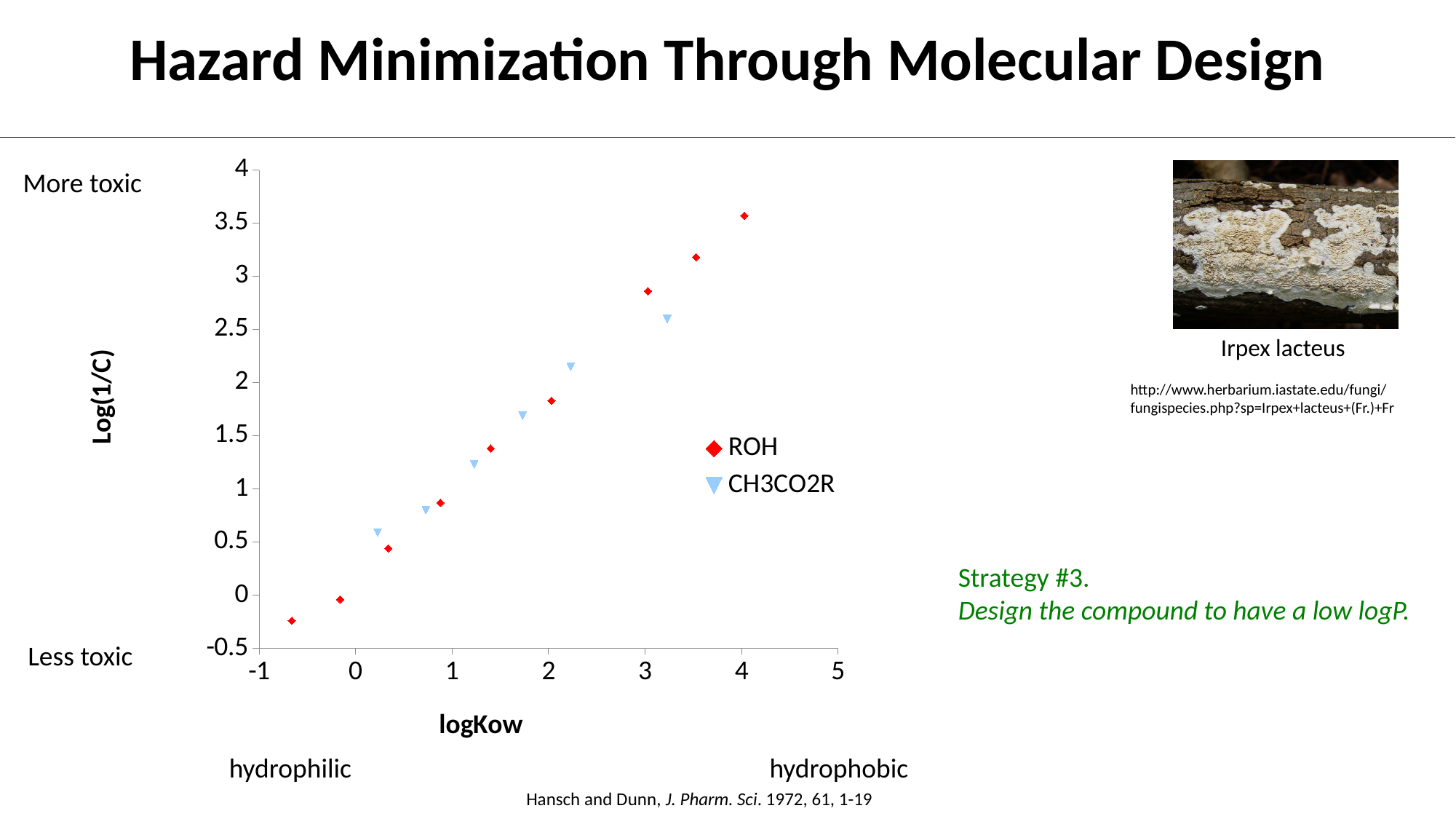
Is the highest Log(1/C) value for the CH3CO2R series greater or less than 3? less Do the Log(1/C) values for the CH3CO2R series rise or fall as logKow increases? rise What kind of chart is shown on the slide? scatter chart Which two series are listed in the legend? ROH and CH3CO2R What is the title of the x axis? logKow How many CH3CO2R data points are plotted? 6 Do the Log(1/C) values for the ROH series rise or fall as logKow increases? rise Is the lowest Log(1/C) value for the ROH series greater or less than 0? less How many series does the legend list? 2 Is the highest Log(1/C) value for the ROH series greater or less than 3.5? greater Which series reaches the higher maximum Log(1/C) value, ROH or CH3CO2R? ROH How many ROH data points are plotted? 9